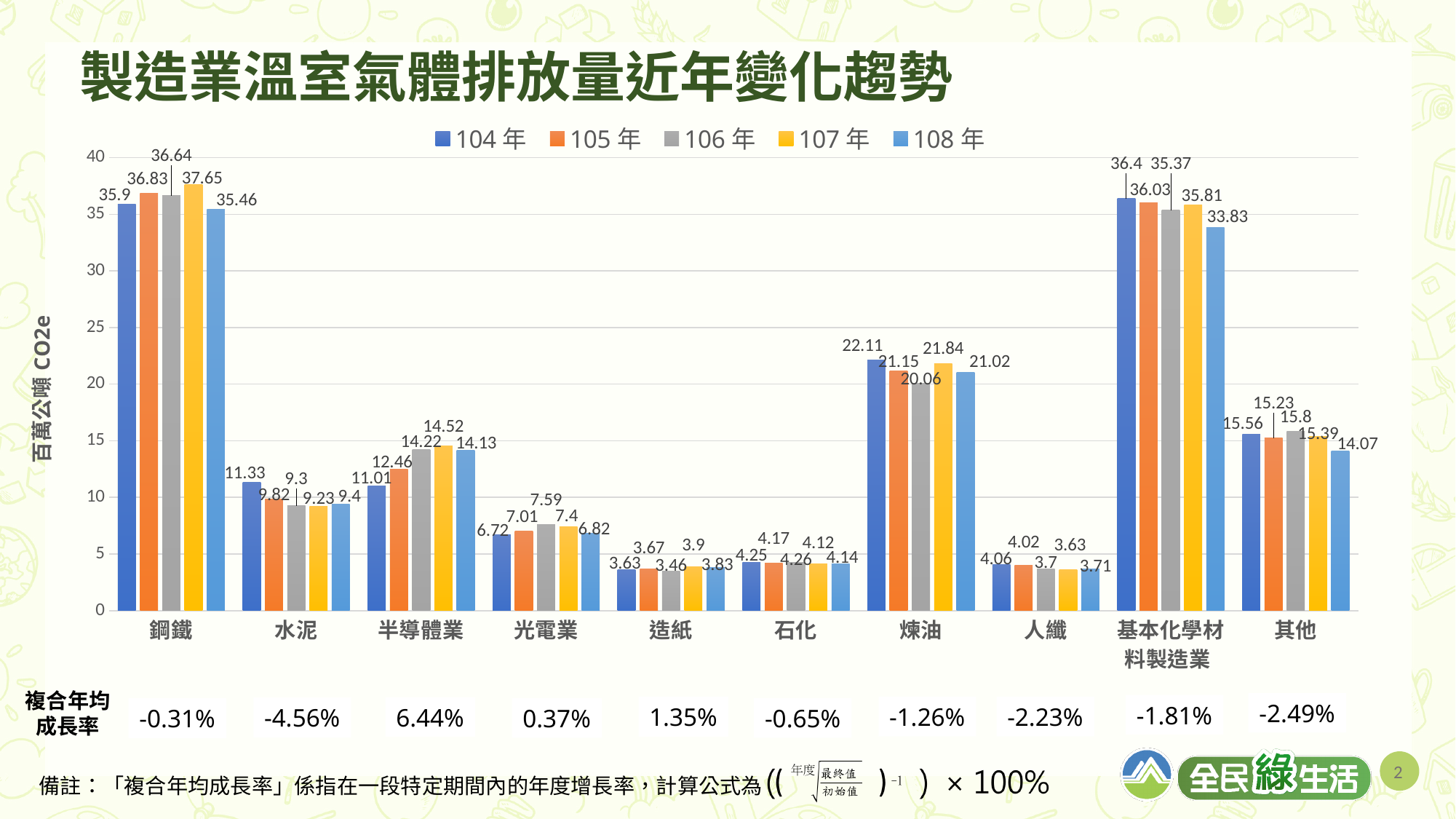
How many categories are shown on the x axis? 10 What is the value for 基本化學材料製造業 in the 108 年 series? 33.83 Which category has the highest value in the 108 年 series? 鋼鐵 How many series does the legend list? 5 What is the value for 鋼鐵 in the 107 年 series? 37.65 What is the difference between the 104 年 and 108 年 values for 水泥? 1.93 Is the value for 其他 in the 106 年 series greater or less than 15? greater What is the value for 煉油 in the 104 年 series? 22.11 What is the y-axis label of the chart? 百萬公噸 CO2e What kind of chart is shown on the slide? bar chart Which category has the lowest value in the 104 年 series? 造紙 Which is larger for 半導體業: the 104 年 value or the 107 年 value? 107 年